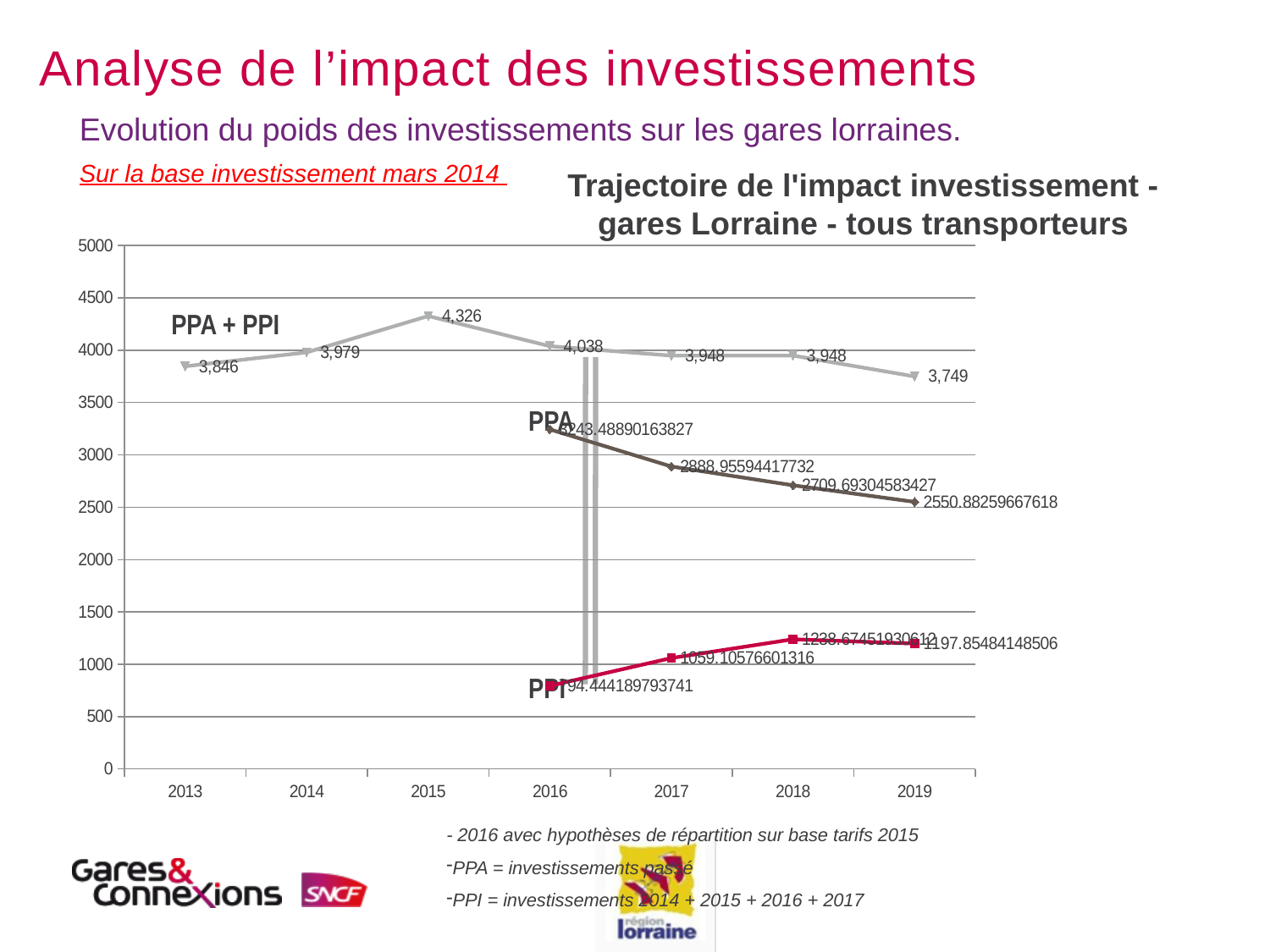
What is the value of the PPA + PPI series in 2015? 4,326 In which year does the PPA + PPI series reach its highest value? 2015 In which year does the PPA + PPI series have its lowest value? 2019 What is the value of the PPA series in 2019? 2550.88259667618 What is the value of the PPI series in 2017? 1059.10576601316 What is the value of the PPA + PPI series in 2013? 3,846 Does the PPA series rise or fall from 2016 to 2019? fall How many years are shown on the x axis? 7 Is the value of the PPA series in 2016 greater or less than 3000? greater Which is larger for the PPA series: the 2017 value or the 2018 value? 2017 What is the difference between the PPA + PPI values for 2015 and 2019? 577 What kind of chart is shown on the slide? line chart